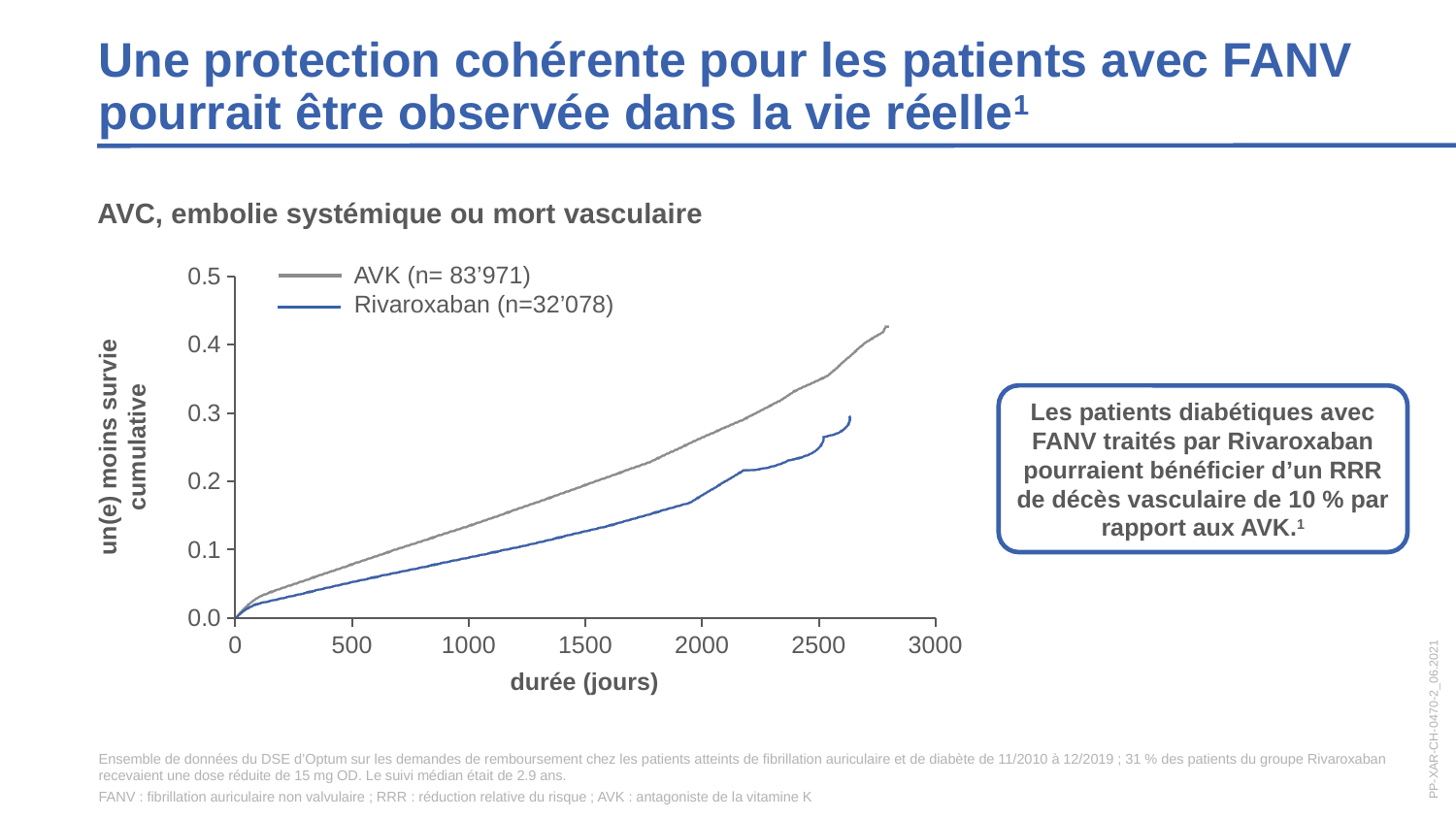
Is the value of the AVK curve at 1000 days greater or less than 0.1? greater Is the value of the AVK curve at 2000 days greater or less than 0.2? greater Do the values of the AVK curve rise or fall as the duration in days increases? rise Is the value of the Rivaroxaban curve at 2000 days greater or less than 0.2? less Which series has the higher cumulative value at 2000 days, AVK or Rivaroxaban? AVK Which series reaches the highest value on the chart? AVK (n= 83'971) What is the label of the x axis of the chart? durée (jours) How many series does the chart legend list? 2 What are the two series named in the chart legend? AVK (n= 83'971) and Rivaroxaban (n=32'078) What kind of chart is shown on the slide? line chart